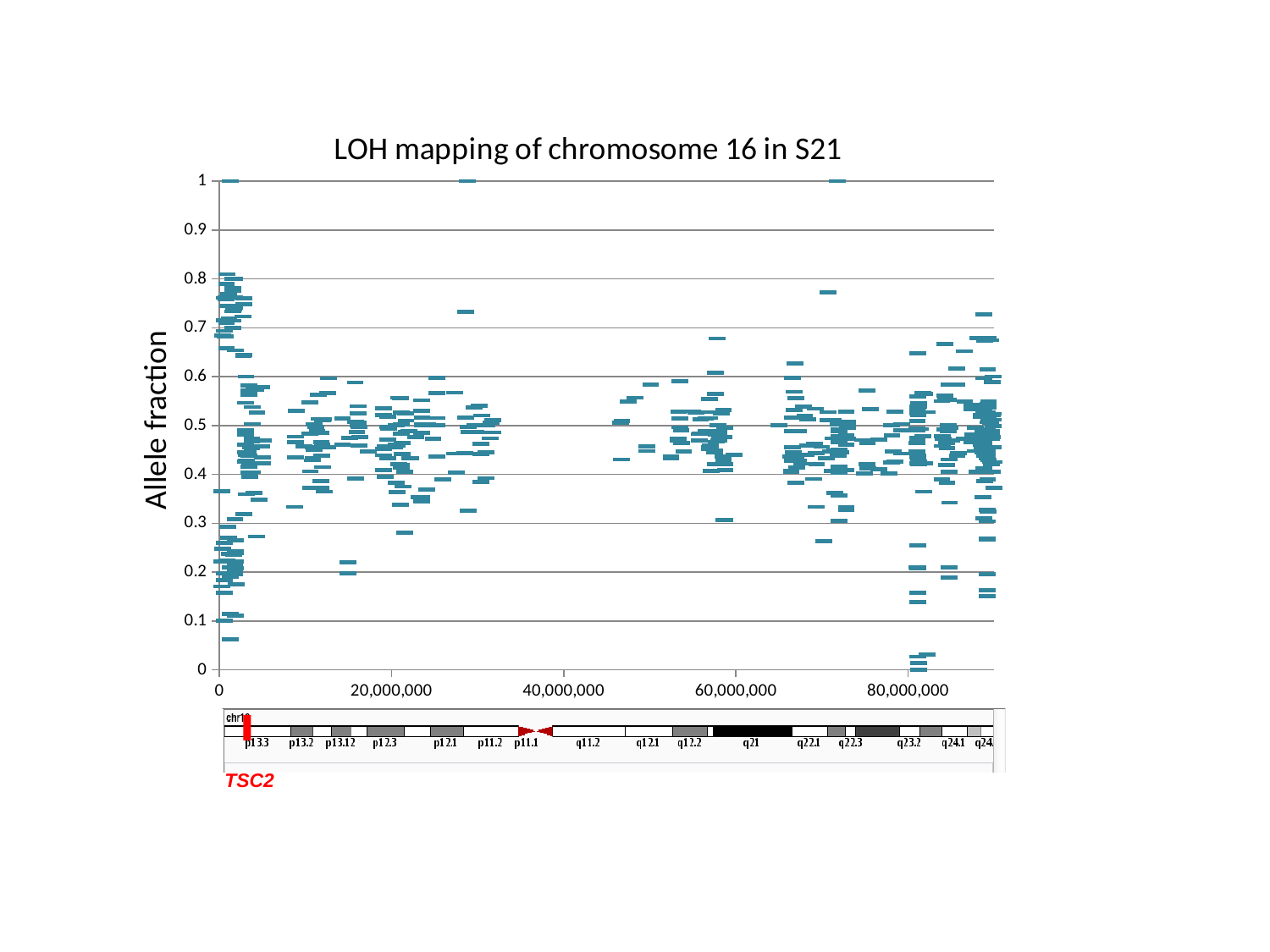
What is the label on the y axis of the chart? Allele fraction What is the highest value shown on the y axis of the chart? 1 What is the title of the chart? LOH mapping of chromosome 16 in S21 What kind of chart is shown on the slide? scatter chart What is the largest tick label shown on the x axis of the chart? 80,000,000